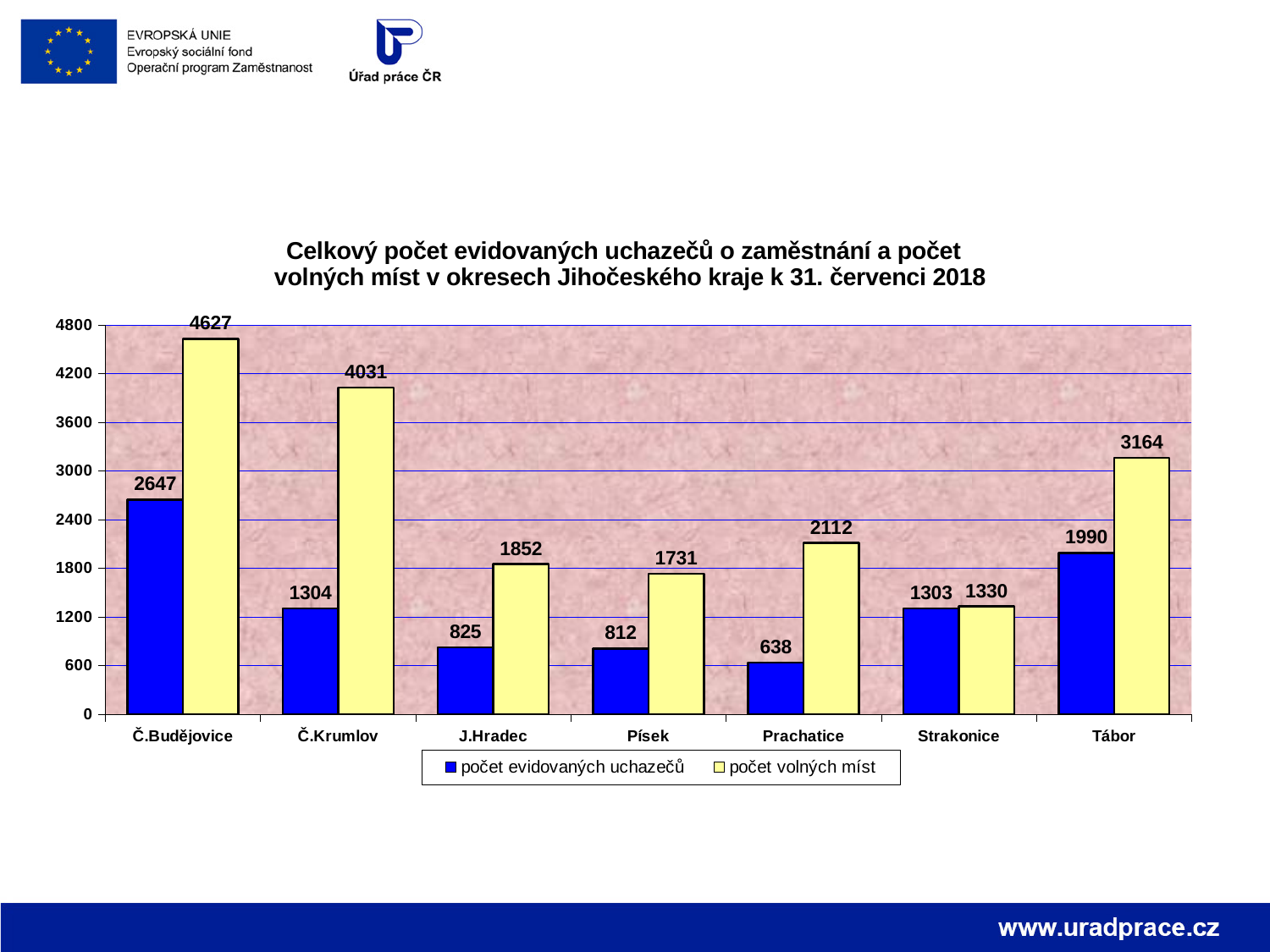
Which district has the highest value for 'počet volných míst'? Č.Budějovice What is the value of 'počet volných míst' for Prachatice? 2112 What colour are the bars for 'počet evidovaných uchazečů'? blue Which district has the lowest value for 'počet evidovaných uchazečů'? Prachatice How many series does the legend list? 2 How many districts are shown on the x axis? 7 What kind of chart is shown on the slide? bar chart Is the value of 'počet volných míst' for J.Hradec greater or less than 1800? greater What is the difference between 'počet volných míst' and 'počet evidovaných uchazečů' for Č.Krumlov? 2727 Which is larger for Strakonice: 'počet evidovaných uchazečů' or 'počet volných míst'? počet volných míst What is the value of 'počet volných míst' for Tábor? 3164 What is the value of 'počet evidovaných uchazečů' for Č.Budějovice? 2647